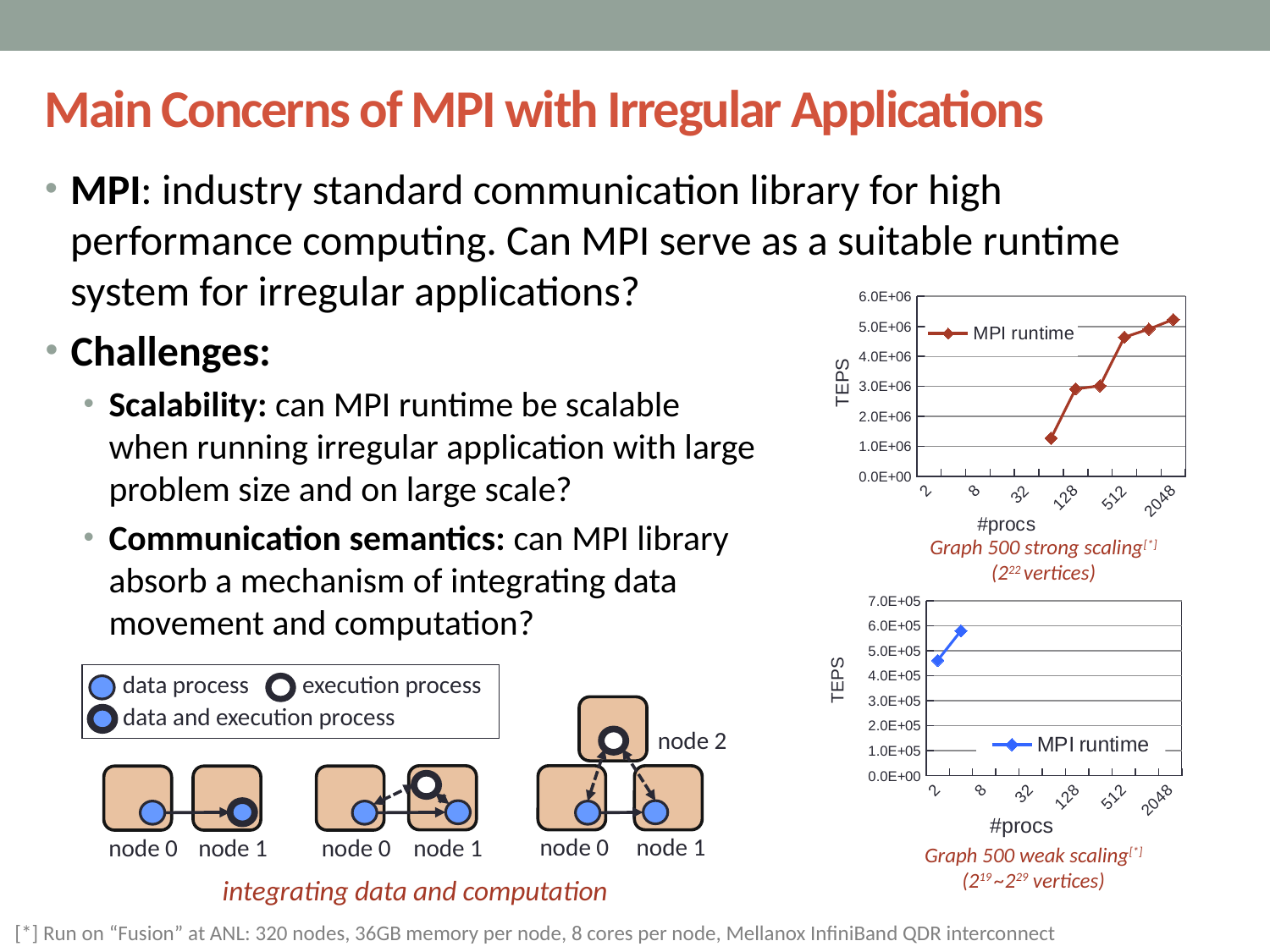
In the Graph 500 weak scaling chart, is the TEPS value of the rightmost data point greater or less than 5.0E+05? greater How many data points are plotted in the Graph 500 weak scaling chart? 2 In the Graph 500 strong scaling chart, is the TEPS value of the leftmost data point greater or less than 2.0E+06? less How many series does the legend of the Graph 500 weak scaling chart list? 1 In the Graph 500 strong scaling chart, do the TEPS values rise or fall as #procs increases? rise What is the name of the series shown in the legend of the Graph 500 strong scaling chart? MPI runtime What is the x-axis label of the Graph 500 weak scaling chart? #procs What kind of chart is the Graph 500 strong scaling chart? line chart In the Graph 500 strong scaling chart, is the TEPS value at 2048 procs greater or less than 5.0E+06? greater In the Graph 500 weak scaling chart, do the TEPS values rise or fall as #procs increases? rise How many data points are plotted in the Graph 500 strong scaling chart? 6